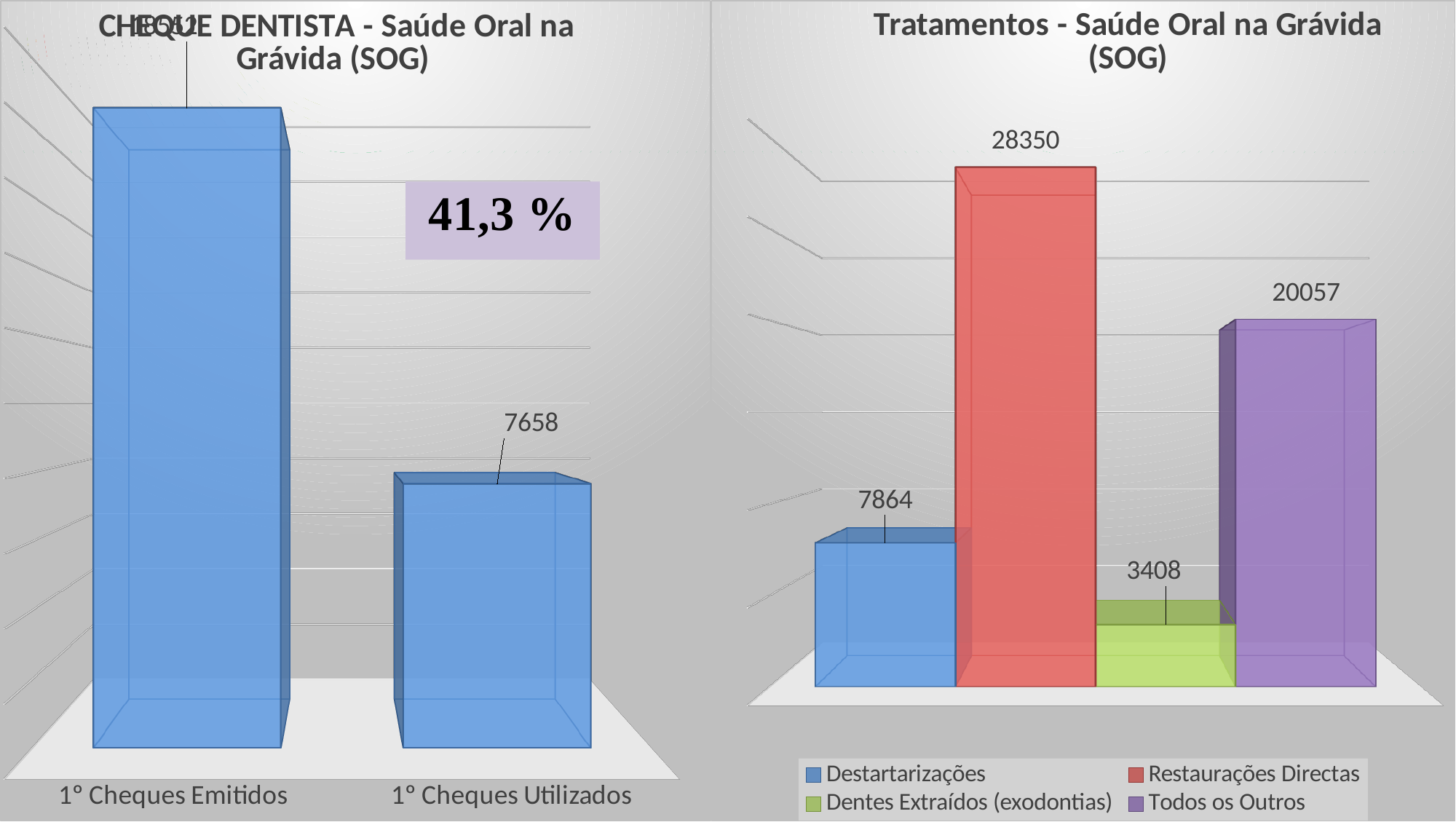
How many bars are shown in the 'CHEQUE DENTISTA - Saúde Oral na Grávida (SOG)' chart? 2 In the 'Tratamentos - Saúde Oral na Grávida (SOG)' chart, which category has the highest value? Restaurações Directas How many entries does the legend of the 'Tratamentos - Saúde Oral na Grávida (SOG)' chart list? 4 In the 'Tratamentos - Saúde Oral na Grávida (SOG)' chart, which category has the lowest value? Dentes Extraídos (exodontias) In the 'Tratamentos - Saúde Oral na Grávida (SOG)' chart, what is the value for Restaurações Directas? 28350 In the 'CHEQUE DENTISTA - Saúde Oral na Grávida (SOG)' chart, what is the value for 1º Cheques Utilizados? 7658 In the 'CHEQUE DENTISTA - Saúde Oral na Grávida (SOG)' chart, which category has the higher bar, 1º Cheques Emitidos or 1º Cheques Utilizados? 1º Cheques Emitidos In the 'Tratamentos - Saúde Oral na Grávida (SOG)' chart, what is the difference between Restaurações Directas and Todos os Outros? 8293 In the 'Tratamentos - Saúde Oral na Grávida (SOG)' chart, what is the value for Dentes Extraídos (exodontias)? 3408 In the 'Tratamentos - Saúde Oral na Grávida (SOG)' chart, what is the value for Todos os Outros? 20057 What type of chart is the 'CHEQUE DENTISTA - Saúde Oral na Grávida (SOG)' chart? Bar chart What percentage is shown in the text box on the 'CHEQUE DENTISTA - Saúde Oral na Grávida (SOG)' chart? 41,3 %